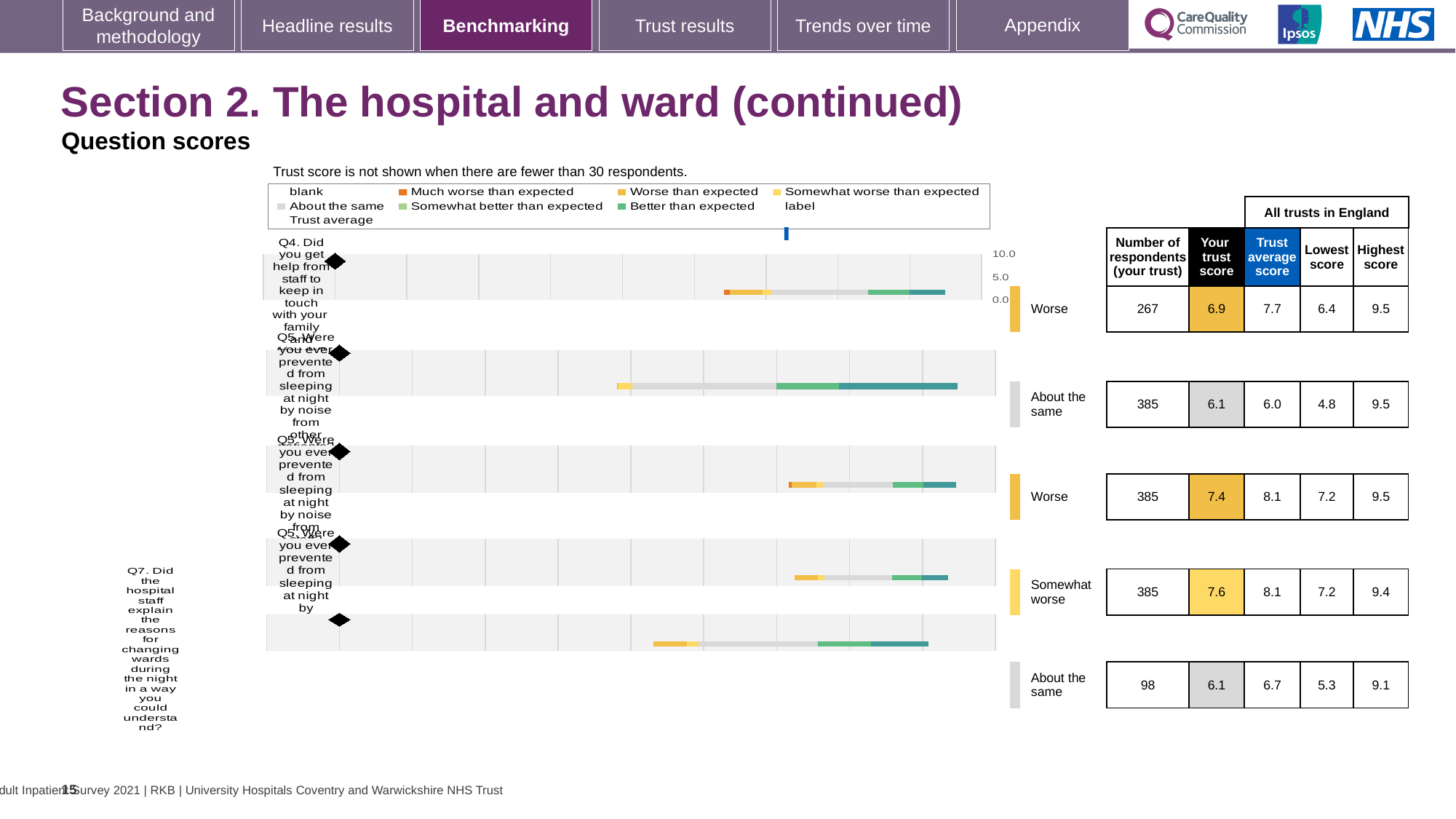
What is the highest 'Your trust score' value shown in the table? 7.6 According to the note above the chart, below how many respondents is the trust score not shown? 30 How many respondents are listed for Q7 (explaining reasons for changing wards during the night)? 98 For Q4, which is larger: your trust score or the trust average score? Trust average score What benchmark category is shown for Q4? Worse What kind of chart is used to show the question scores on this slide? bar chart How many question rows (bars) are plotted in the question scores chart? 5 Which question row has the lowest number of respondents? Q7 What is the 'Your trust score' value for Q4 (help from staff to keep in touch with family and friends)? 6.9 What is the 'Highest score' across all trusts in England for Q7? 9.1 What is the difference between the trust average score (7.7) and your trust score (6.9) for Q4? 0.8